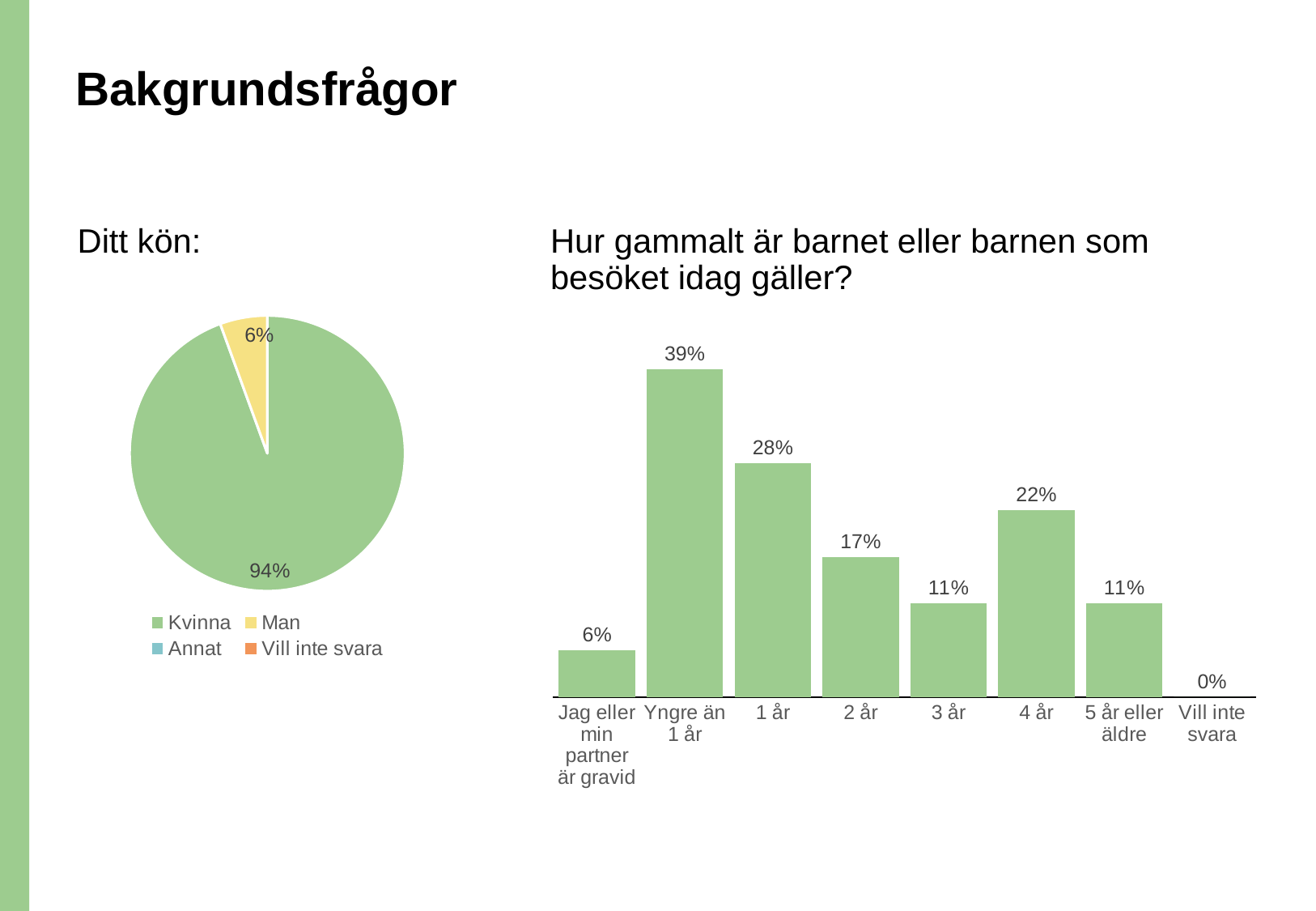
How many categories are shown on the x axis of the 'Hur gammalt är barnet eller barnen som besöket idag gäller?' chart? 8 In the 'Ditt kön:' pie chart, what share is labelled for Kvinna? 94% What kind of chart is the 'Ditt kön:' chart on the left? Pie chart In the 'Hur gammalt är barnet eller barnen som besöket idag gäller?' chart, which is larger: the value for '4 år' or the value for '2 år'? 4 år In the 'Hur gammalt är barnet eller barnen som besöket idag gäller?' chart, which category has the lowest value? Vill inte svara In the 'Hur gammalt är barnet eller barnen som besöket idag gäller?' chart, what is the difference between the values for '1 år' and '2 år'? 11% In the 'Hur gammalt är barnet eller barnen som besöket idag gäller?' chart, what is the value for '4 år'? 22% What kind of chart is the 'Hur gammalt är barnet eller barnen som besöket idag gäller?' chart on the right? Bar chart In the 'Hur gammalt är barnet eller barnen som besöket idag gäller?' chart, what is the value for 'Yngre än 1 år'? 39% In the 'Hur gammalt är barnet eller barnen som besöket idag gäller?' chart, which category has the highest value? Yngre än 1 år In the 'Ditt kön:' pie chart, how many entries does the legend list? 4 In the 'Ditt kön:' pie chart, what share is labelled for Man? 6%